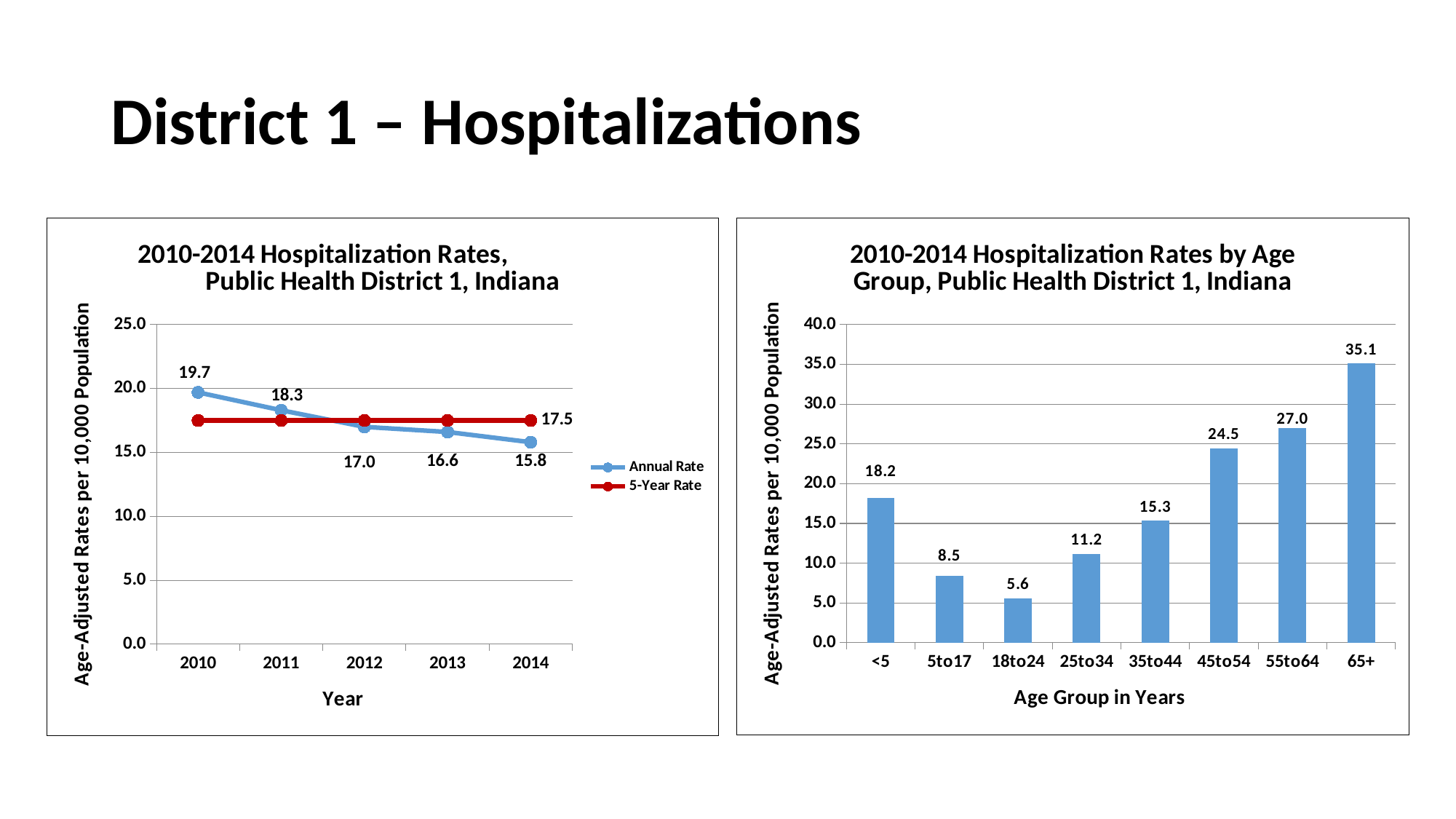
In the left chart, does the Annual Rate rise or fall from 2010 to 2014? fall In the left chart, what is the difference between the Annual Rate in 2010 and in 2014? 3.9 In the left chart, what is the 5-Year Rate? 17.5 In the right chart (2010-2014 Hospitalization Rates by Age Group), which age group has the highest rate? 65+ In the left chart, what type of chart is shown? line chart In the right chart, which age group has the lowest rate? 18to24 In the left chart, what is the Annual Rate for 2014? 15.8 In the left chart (2010-2014 Hospitalization Rates, Public Health District 1, Indiana), what is the Annual Rate for 2010? 19.7 In the right chart, which is larger, the rate for <5 or the rate for 35to44? <5 In the right chart, what is the rate for the 45to54 age group? 24.5 In the right chart, how many age groups are shown? 8 In the left chart, how many series does the legend list? 2